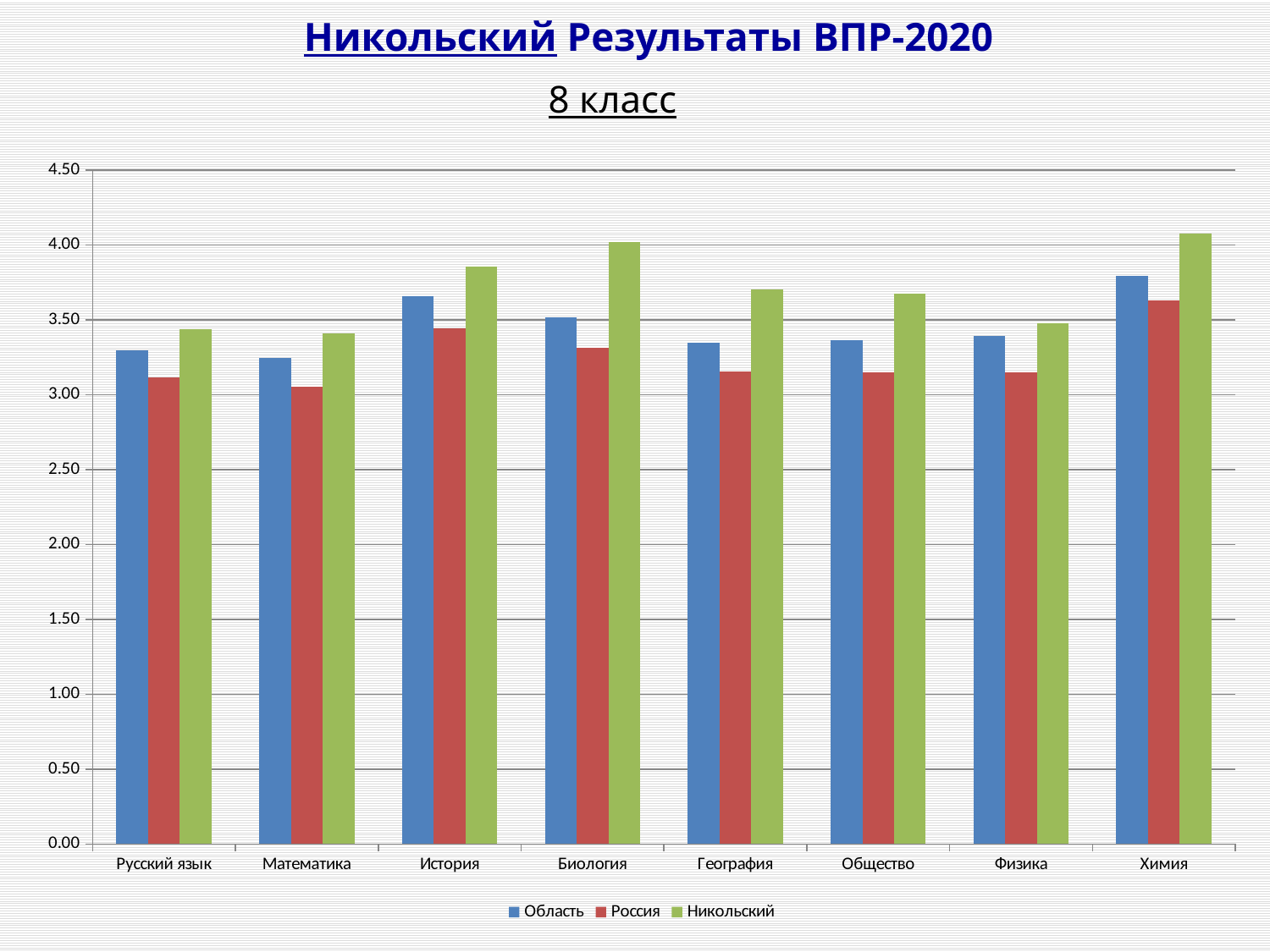
How many series does the legend list? 3 What kind of chart is shown on the slide? bar chart In Биология, which is larger: the value for Никольский or the value for Область? Никольский How many subjects (categories) are shown on the x axis? 8 Which subject has the highest value for the Область series? Химия Is the value for Россия in Химия greater or less than 3.50? greater Which subject has the lowest value for the Россия series? Математика Is the value for Никольский in Биология greater or less than 4.00? greater Is the value for Область in История greater or less than 3.50? greater In Химия, which is larger: the value for Область or the value for Россия? Область Which series is shown in green in the legend? Никольский